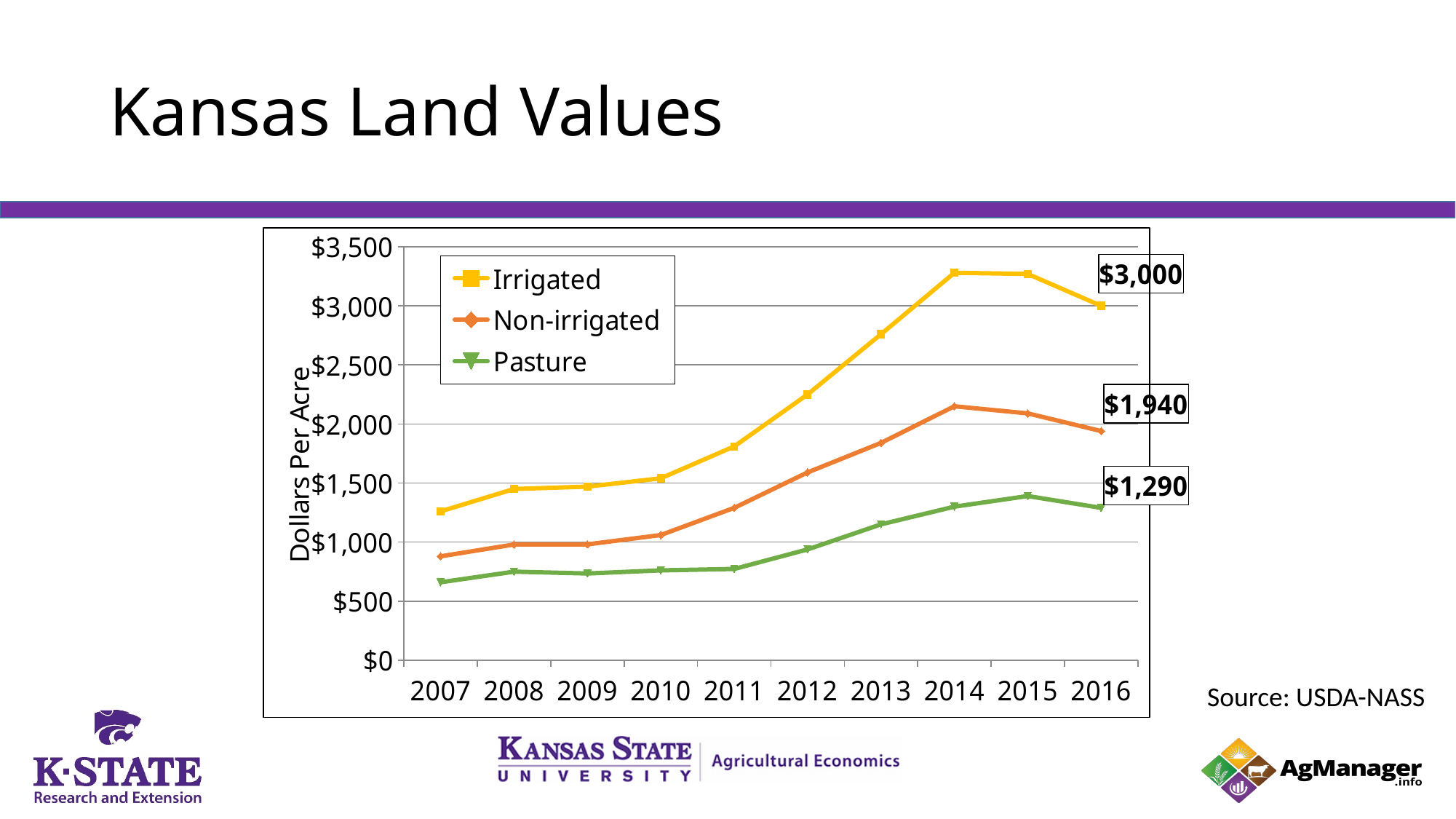
What is the value for Non-irrigated land in 2016? $1,940 Is the value for Irrigated land in 2014 greater or less than $3,000? greater What is the value for Irrigated land in 2016? $3,000 What kind of chart is shown on the slide? Line chart What is the difference between the Non-irrigated and Pasture values in 2016? $650 Is the value for Pasture in 2007 greater or less than $1,000? less What is the value for Pasture in 2016? $1,290 Which series has the highest value in 2016? Irrigated Which series has the lowest value in 2016? Pasture What is the difference between the Irrigated and Non-irrigated values in 2016? $1,060 How many series does the legend list? 3 How many years are shown on the x axis? 10